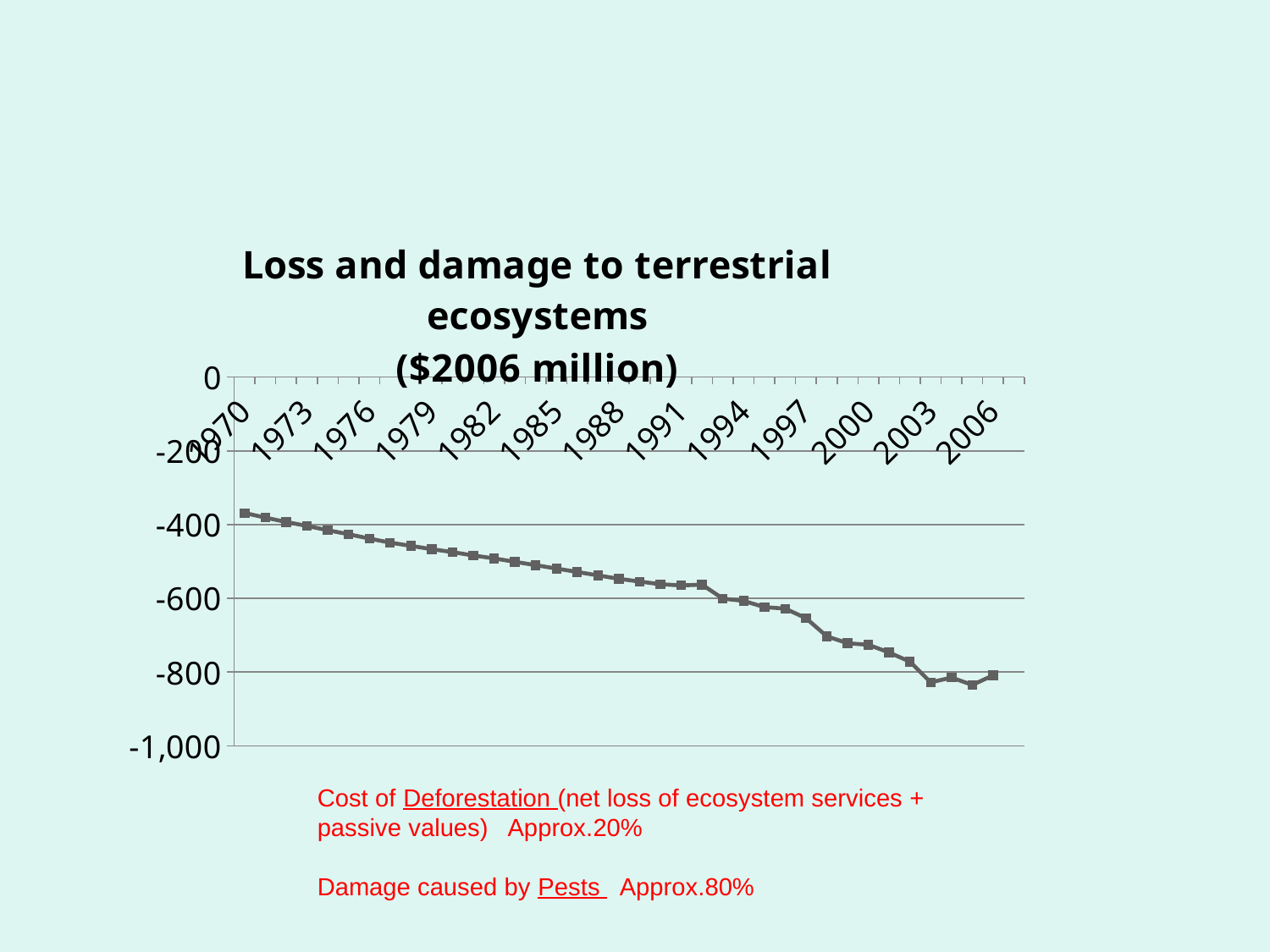
Is the value for 1970 greater or less than -400? greater Is the value for 1991 greater or less than -600? greater How many year labels are shown on the x axis? 13 Is the value for 1982 greater or less than -400? less Which year has the highest (least negative) value on the chart? 1970 What kind of chart is shown on the slide? line chart Which is larger, the value for 1985 or the value for 2000? 1985 According to the text below the chart, approximately what share of the loss is damage caused by pests? Approx.80% Do the plotted values rise or fall from 1970 to 2006? fall What is the title of the chart? Loss and damage to terrestrial ecosystems ($2006 million)